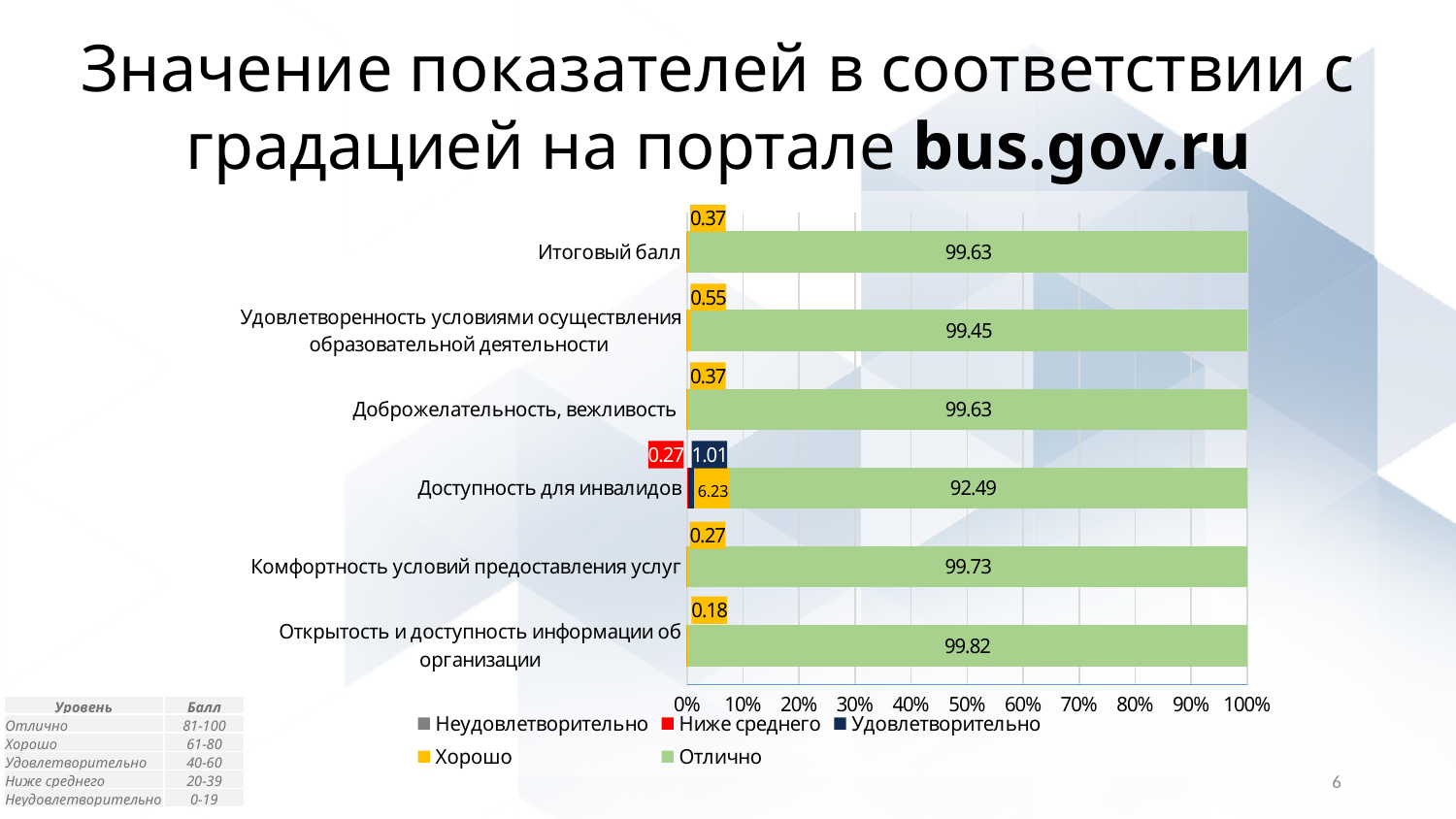
What is the value of the "Удовлетворительно" series for "Доступность для инвалидов"? 1.01 What is the value of the "Отлично" series for "Доступность для инвалидов"? 92.49 How many categories are plotted on the chart? 6 What type of chart is shown on the slide? bar chart What is the value of the "Хорошо" series for "Открытость и доступность информации об организации"? 0.18 Which category has the lowest value in the "Отлично" series? Доступность для инвалидов What is the value of the "Отлично" series for "Итоговый балл"? 99.63 Which category has the highest value in the "Отлично" series? Открытость и доступность информации об организации How many series does the chart legend list? 5 Which series is shown in green in the legend? Отлично What is the value of the "Хорошо" series for "Удовлетворенность условиями осуществления образовательной деятельности"? 0.55 What is the difference between the "Отлично" values for "Комфортность условий предоставления услуг" and "Доступность для инвалидов"? 7.24